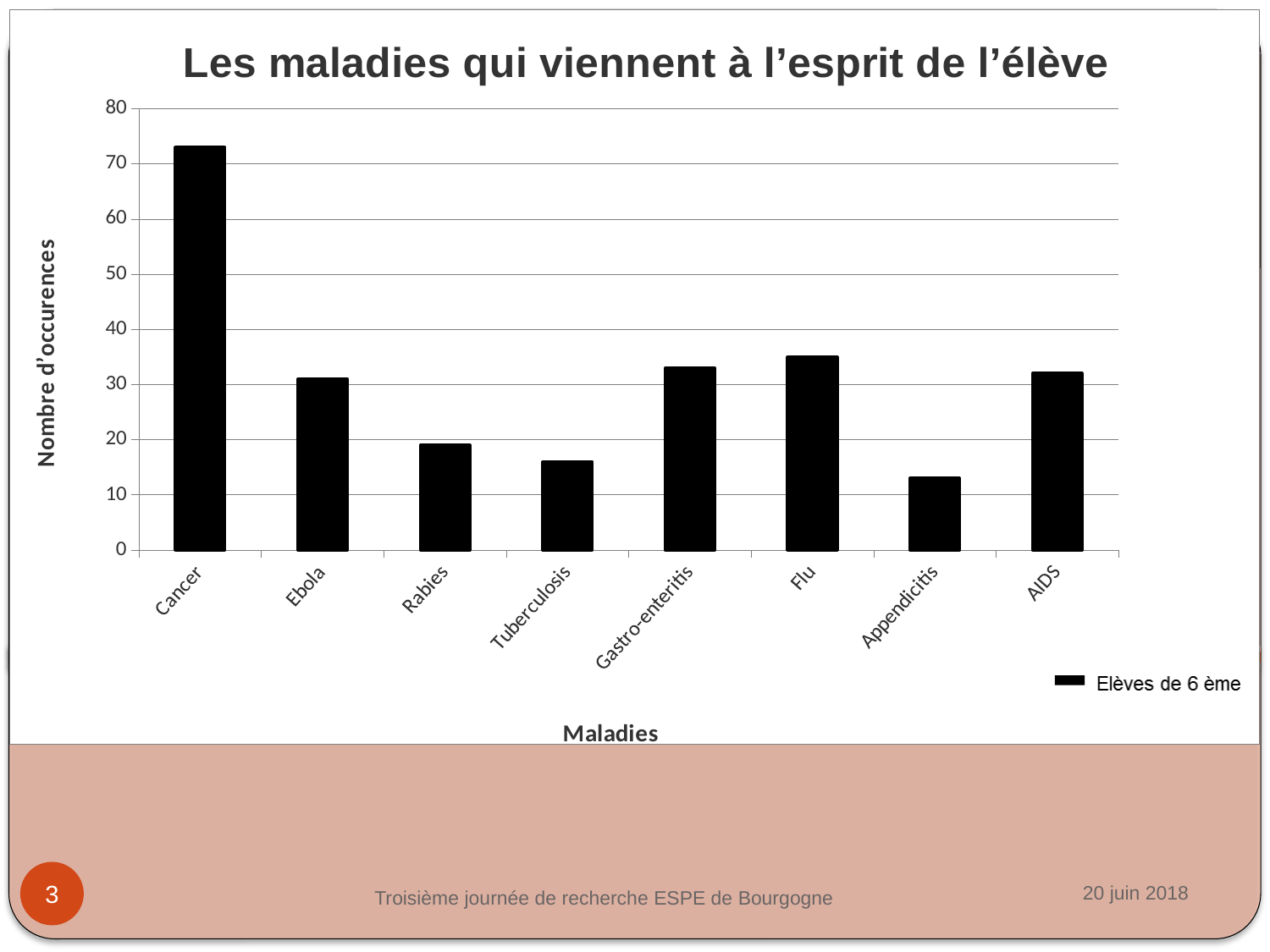
Which disease has the highest number of occurrences? Cancer Which has more occurrences, Cancer or Ebola? Cancer Which disease has the lowest number of occurrences? Appendicitis How many series does the legend list? 1 Is the value for Cancer greater or less than 70? greater What is the title of the chart? Les maladies qui viennent à l'esprit de l'élève Which has more occurrences, Flu or Appendicitis? Flu Is the value for Flu greater or less than 30? greater Is the value for Tuberculosis greater or less than 20? less What kind of chart is shown on the slide? bar chart How many diseases are shown on the x axis? 8